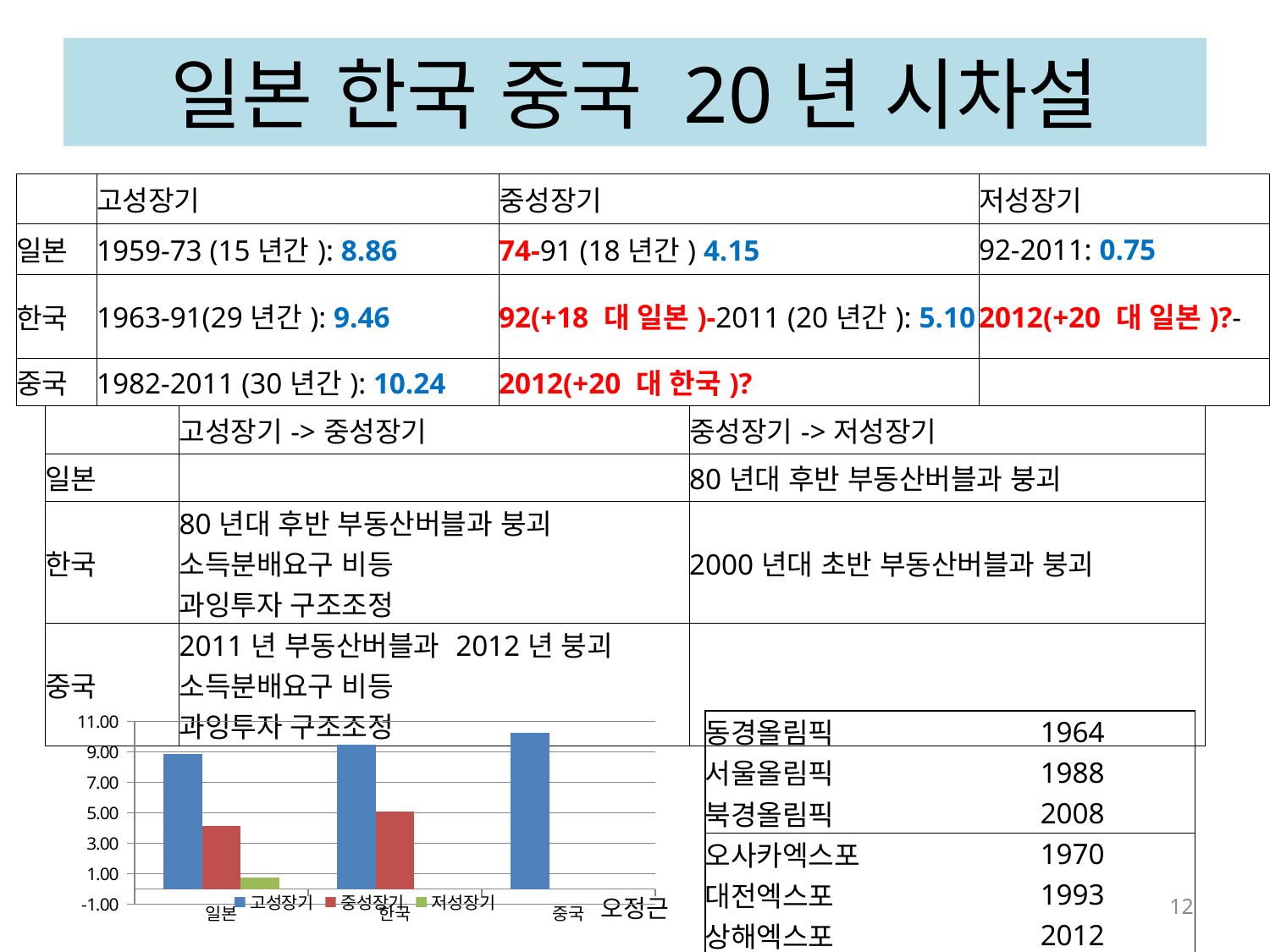
In the bar chart, which category has the highest 고성장기 bar? 중국 In the bar chart, is the 고성장기 value for 일본 greater or less than 7.00? greater In the bar chart, which category has only a 고성장기 bar and no 중성장기 or 저성장기 bar? 중국 In the bar chart, which is larger: the 고성장기 value for 중국 or the 고성장기 value for 일본? 중국 In the bar chart, which is larger: the 중성장기 value for 한국 or the 중성장기 value for 일본? 한국 How many categories are shown on the x axis of the bar chart? 3 In the bar chart, is the 중성장기 value for 일본 greater or less than 5.00? less In the bar chart, is the 저성장기 value for 일본 greater or less than 3.00? less How many series does the legend of the bar chart list? 3 In the bar chart, which bar is the lowest of all? 일본 저성장기 What kind of chart is shown at the bottom left of the slide? bar chart